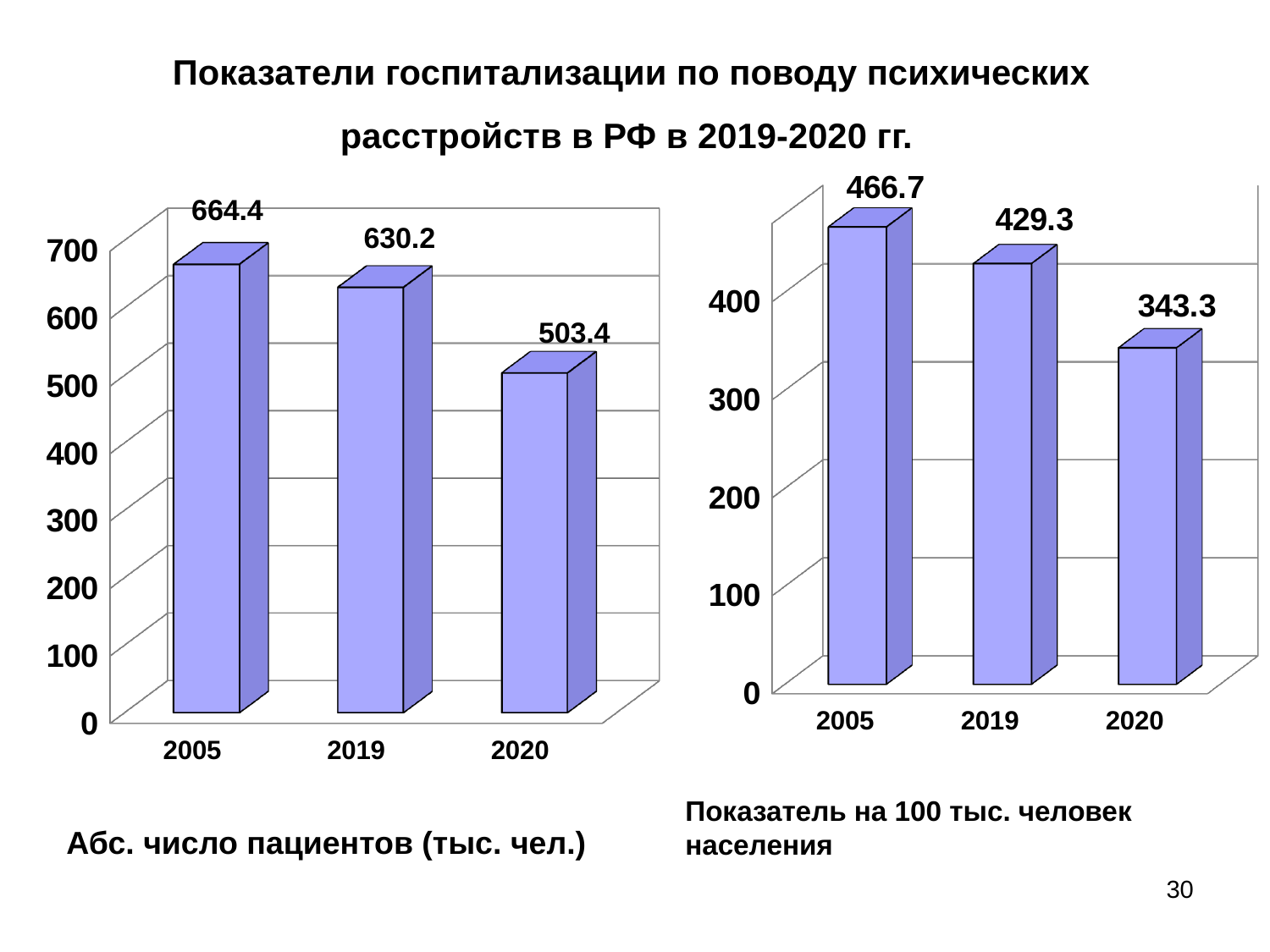
In the right chart (Показатель на 100 тыс. человек населения), what is the value for 2019? 429.3 In the right chart (Показатель на 100 тыс. человек населения), which year has the lowest value? 2020 In the left chart (Абс. число пациентов), what is the value for 2020? 503.4 In the right chart (Показатель на 100 тыс. человек населения), what is the value for 2020? 343.3 In the right chart (Показатель на 100 тыс. человек населения), what is the difference between the values for 2005 and 2020? 123.4 What type of chart is the right chart (Показатель на 100 тыс. человек населения)? bar chart In the left chart (Абс. число пациентов), what is the difference between the values for 2019 and 2020? 126.8 In the right chart (Показатель на 100 тыс. человек населения), which is larger, the value for 2005 or the value for 2019? 2005 How many years (categories) are shown in the left chart (Абс. число пациентов)? 3 In the left chart (Абс. число пациентов), what is the value for 2005? 664.4 In the left chart (Абс. число пациентов), which year has the highest value? 2005 In the left chart (Абс. число пациентов), do the values rise or fall from 2005 to 2020? fall